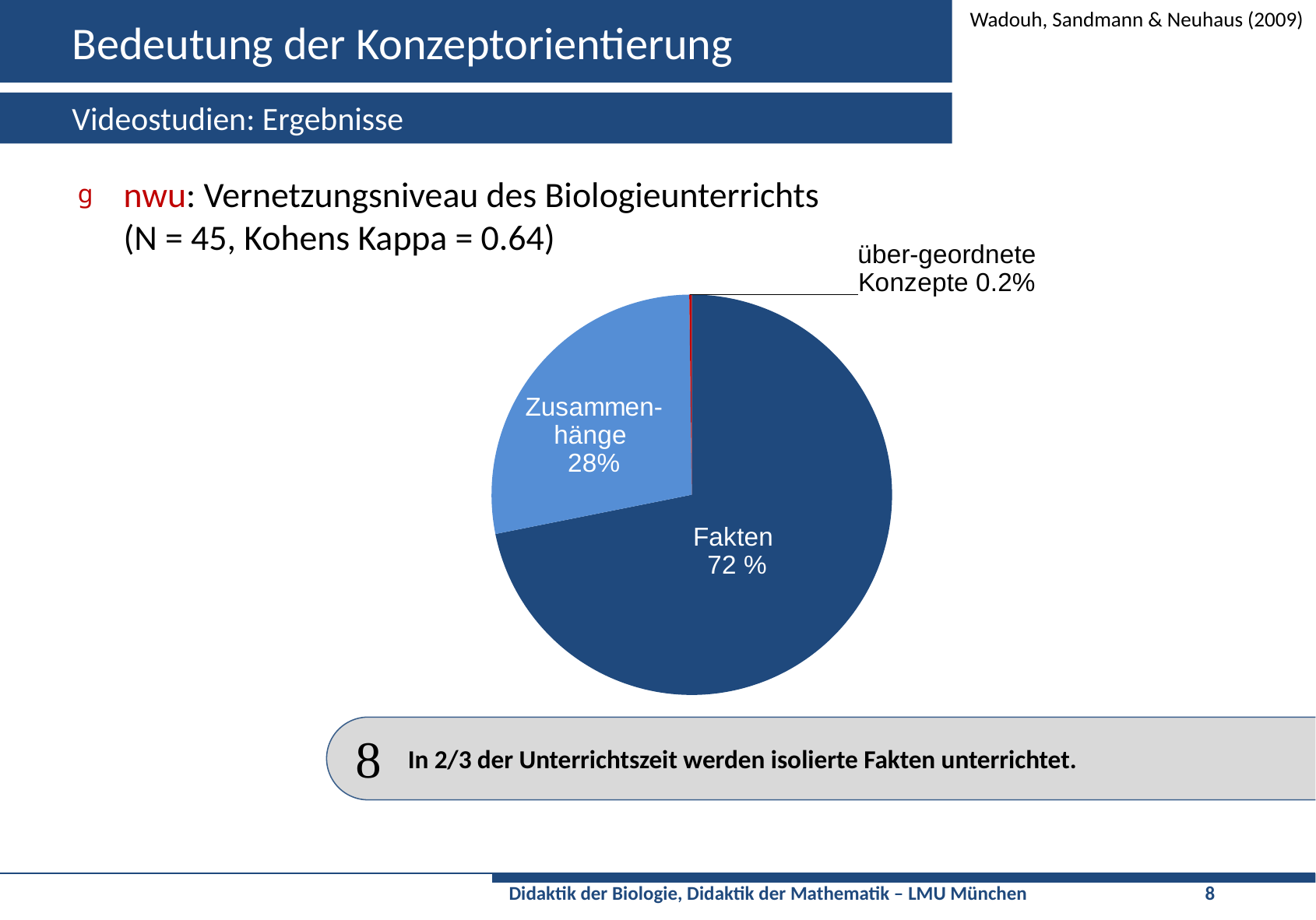
Is the share for Zusammenhänge greater or less than 50%? less What is the difference in percentage points between the Fakten slice and the Zusammenhänge slice? 44 How many slices does the pie chart have? 3 What percentage is shown for über-geordnete Konzepte? 0.2% What kind of chart is shown on the slide? pie chart What share of the pie does the Fakten slice represent? 72 % What colour is the Zusammenhänge slice of the pie chart? light blue What colour is the Fakten slice of the pie chart? dark blue Which is larger, the Fakten slice or the Zusammenhänge slice? Fakten Which slice of the pie chart is the smallest? über-geordnete Konzepte What share of the pie does the Zusammenhänge slice represent? 28% Which slice of the pie chart is the largest? Fakten